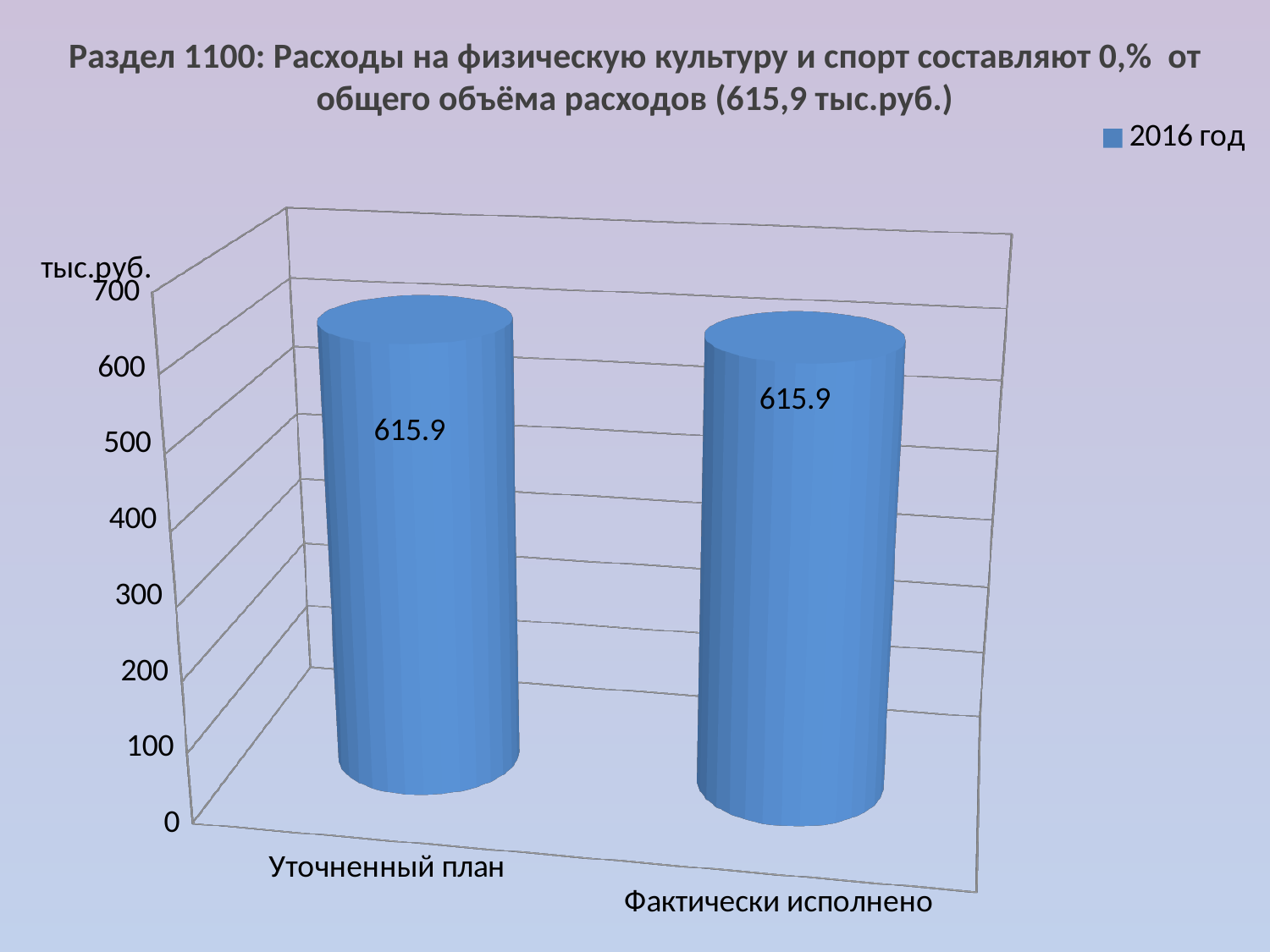
What is the value for Фактически исполнено? 615.9 What series name is shown in the legend? 2016 год Is the value for Фактически исполнено greater or less than 700? less What is the difference between the values for Уточненный план and Фактически исполнено? 0 How many categories are shown on the x axis? 2 Is the value for Уточненный план greater or less than 600? greater How many series does the legend list? 1 What is the value for Уточненный план? 615.9 What unit label is shown on the vertical axis? тыс.руб. What is the total of the two plotted values? 1231.8 What kind of chart is shown on the slide? bar chart